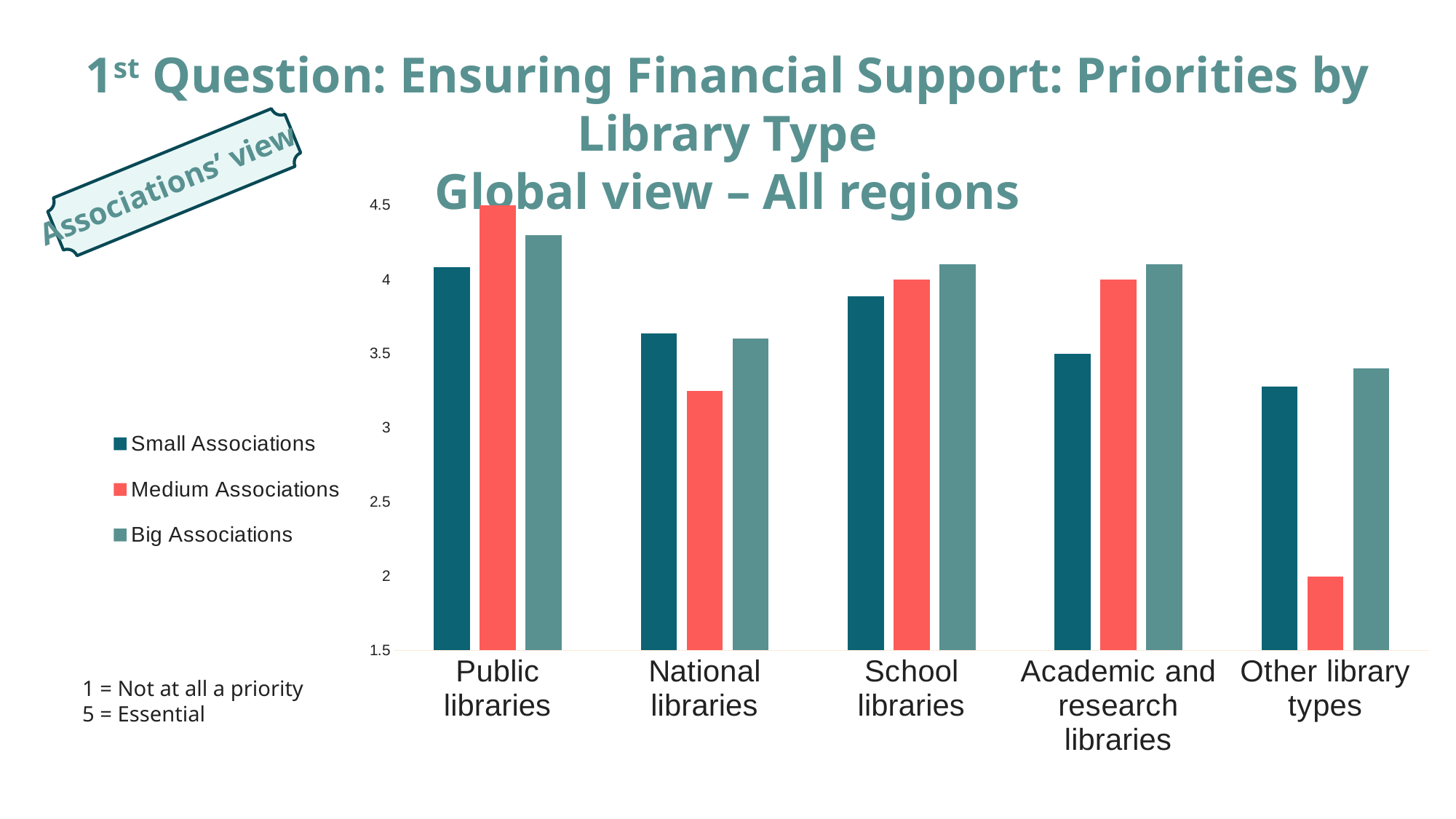
Which library type has the lowest value for Medium Associations? Other library types What is the value for Medium Associations for School libraries? 4 Is the value for Small Associations for National libraries greater or less than 3.5? greater How many library types are shown on the x axis? 5 For Other library types, which is larger: Big Associations or Medium Associations? Big Associations Which library type has the lowest value for Small Associations? Other library types Which library type has the highest value for Medium Associations? Public libraries What is the value for Medium Associations for Other library types? 2 What kind of chart is shown on the slide? bar chart How many series does the legend list? 3 Is the value for Medium Associations for National libraries greater or less than 3.5? less